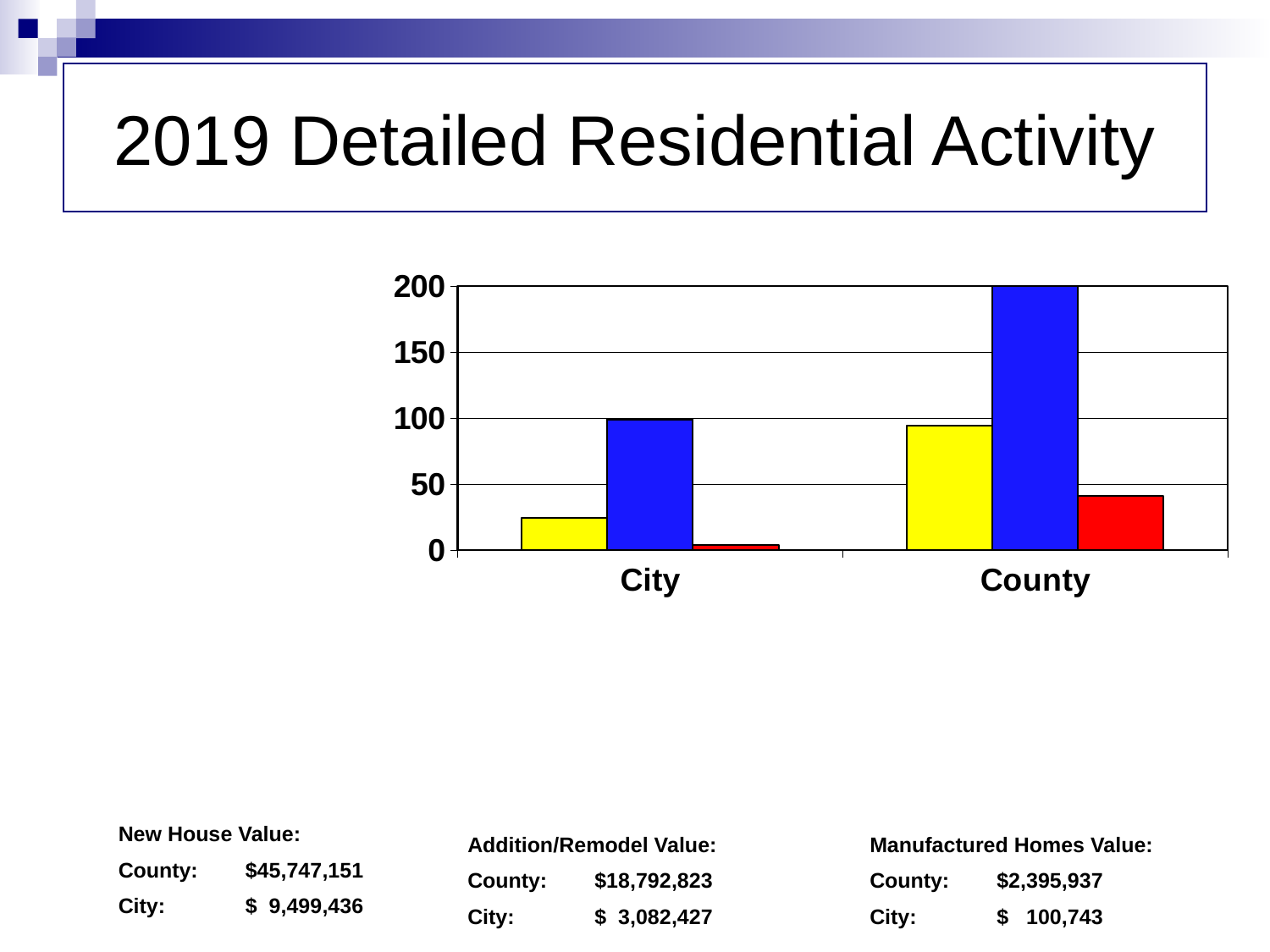
Is the value of the yellow bar for City greater or less than 50? less Is the value of the blue bar for City greater or less than 150? less How many bars are plotted for each category in the chart? 3 Is the value of the blue bar for County greater or less than 150? greater For City, which bar is larger, the yellow bar or the red bar? yellow What kind of chart is shown on the slide? bar chart Which category has the larger blue bar, City or County? County Which bar in the chart is the tallest? the blue bar for County How many categories are shown on the x axis of the chart? 2 What are the two categories on the x axis of the chart? City and County